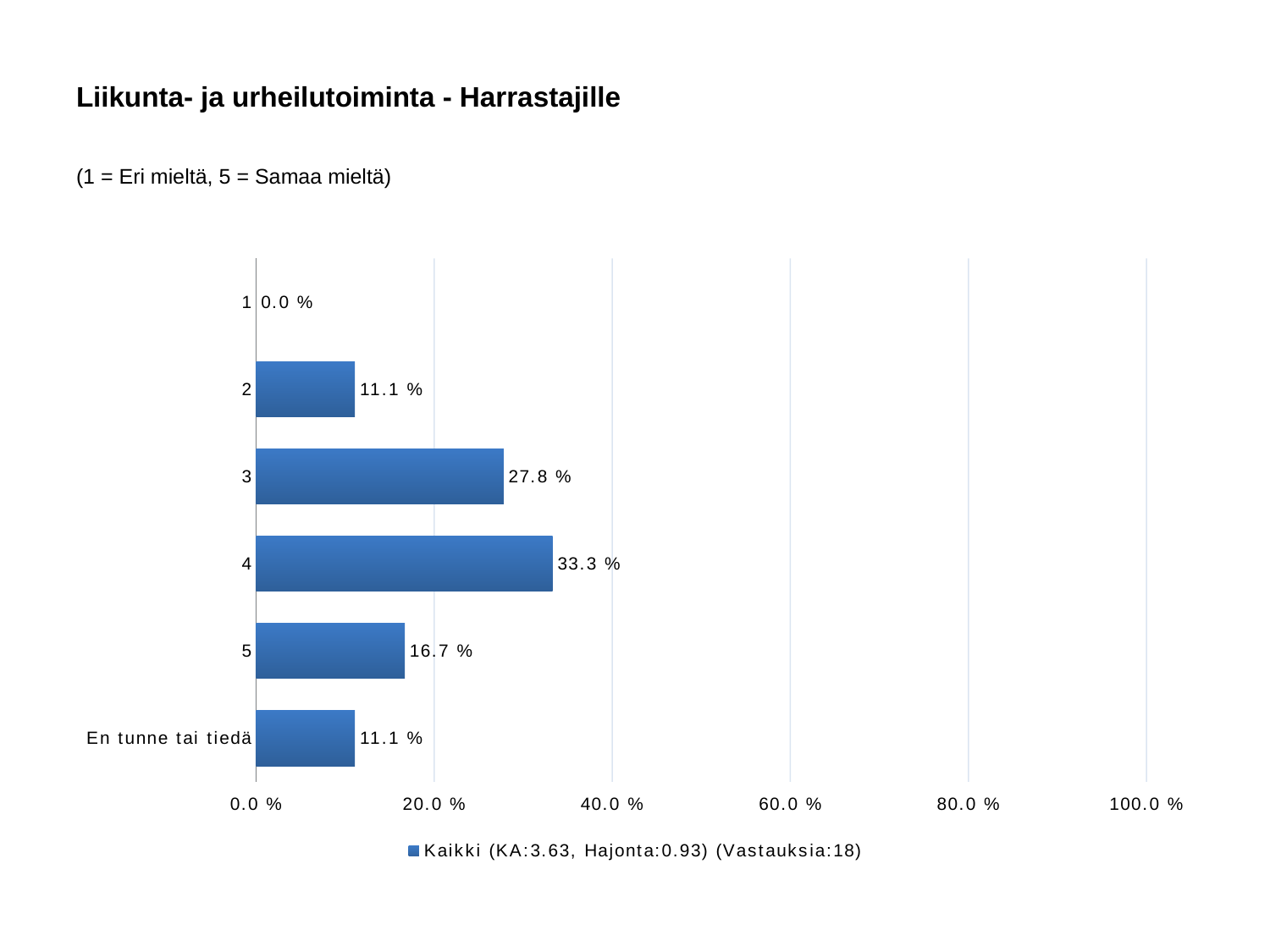
What is the difference between the values for category 4 and category 3? 5.5 % How many series does the legend list? 1 Which category has the highest value? 4 What is the value for category 4? 33.3 % What is the value for 'En tunne tai tiedä'? 11.1 % Is the value for category 4 greater or less than 40.0 %? less What is the value for category 3? 27.8 % Which is larger, the value for category 5 or the value for category 2? 5 What is the title of the slide? Liikunta- ja urheilutoiminta - Harrastajille How many categories are shown on the chart? 6 What kind of chart is shown on the slide? bar chart Which category has the lowest value? 1